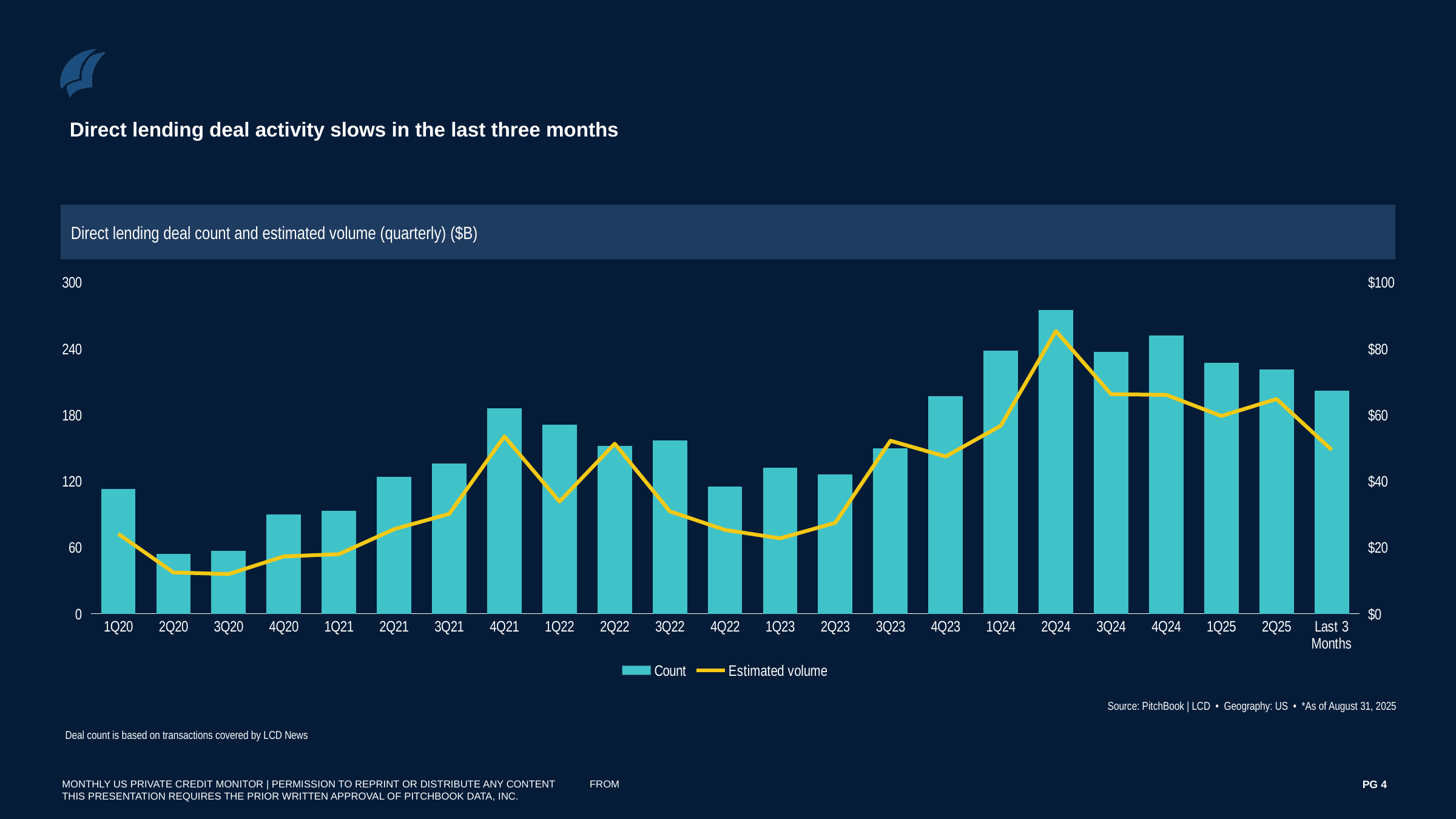
Which has the larger deal count, 1Q20 or 1Q24? 1Q24 How many series does the chart legend list? 2 Is the deal count for 4Q20 greater or less than 120? less In which period does the Estimated volume line reach its highest point? 2Q24 Which period has the highest deal count bar? 2Q24 What is the title of the chart? Direct lending deal count and estimated volume (quarterly) ($B) How many categories are shown on the x axis? 23 Is the deal count for 2Q24 greater or less than 240? greater Does the deal count rise or fall from 2Q24 to the Last 3 Months? fall What are the two series named in the legend? Count and Estimated volume Is the estimated volume for 3Q20 greater or less than $20? less